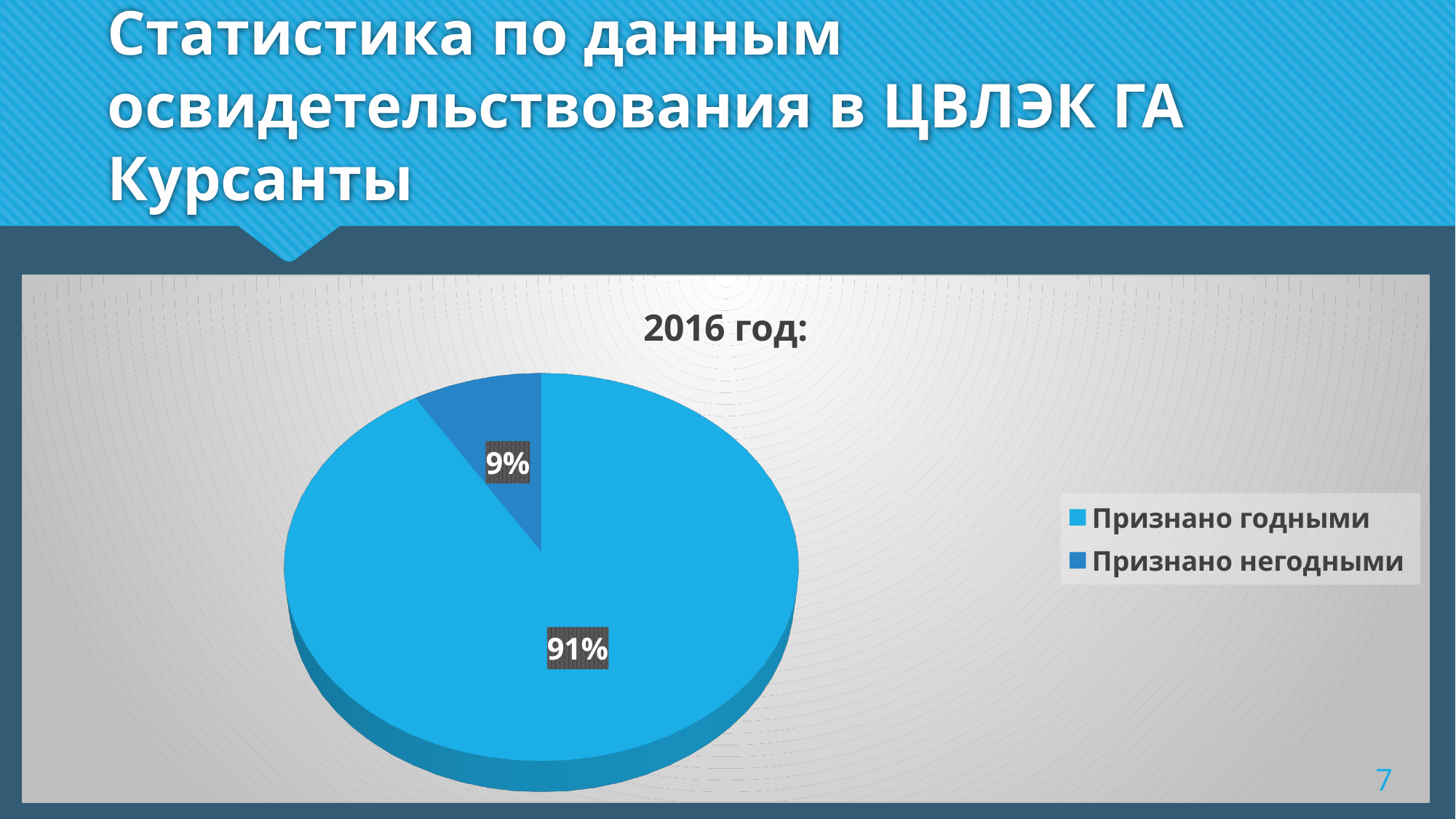
What is the total of the two slice percentages shown on the pie? 100% What share of the pie is labelled "Признано негодными"? 9% What kind of chart is shown on the slide? pie chart Which legend entry is shown in the darker blue colour? Признано негодными How many entries does the legend list? 2 Which slice is larger: "Признано годными" or "Признано негодными"? Признано годными How many slices does the pie chart have? 2 Which category has the smallest slice of the pie? Признано негодными Which category has the largest slice of the pie? Признано годными What is the chart's title? 2016 год: What share of the pie is labelled "Признано годными"? 91% What is the difference in percentage points between the "Признано годными" and "Признано негодными" slices? 82